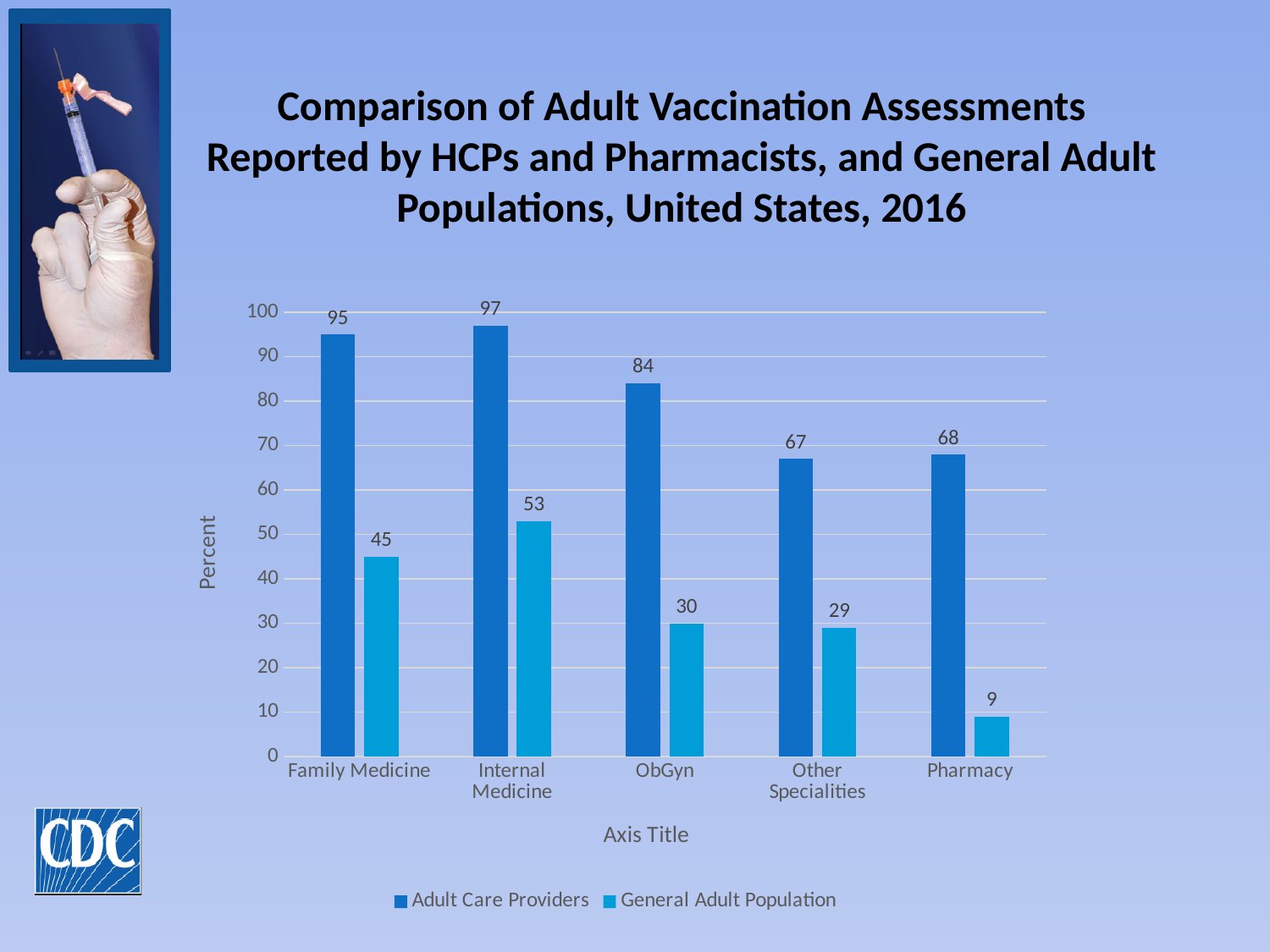
What is the difference between the General Adult Population values for Internal Medicine and Other Specialities? 24 What kind of chart is shown on the slide? Bar chart How many series does the legend list? 2 How many categories are shown on the x axis? 5 What is the value for General Adult Population in Family Medicine? 45 Which category has the highest value for Adult Care Providers? Internal Medicine What is the label of the y axis? Percent What is the difference between the Adult Care Providers and General Adult Population values for ObGyn? 54 What is the value for Adult Care Providers in Internal Medicine? 97 What is the value for General Adult Population in Pharmacy? 9 Which category has the lowest value for General Adult Population? Pharmacy Which is larger: the Adult Care Providers value for Other Specialities or for Pharmacy? Pharmacy